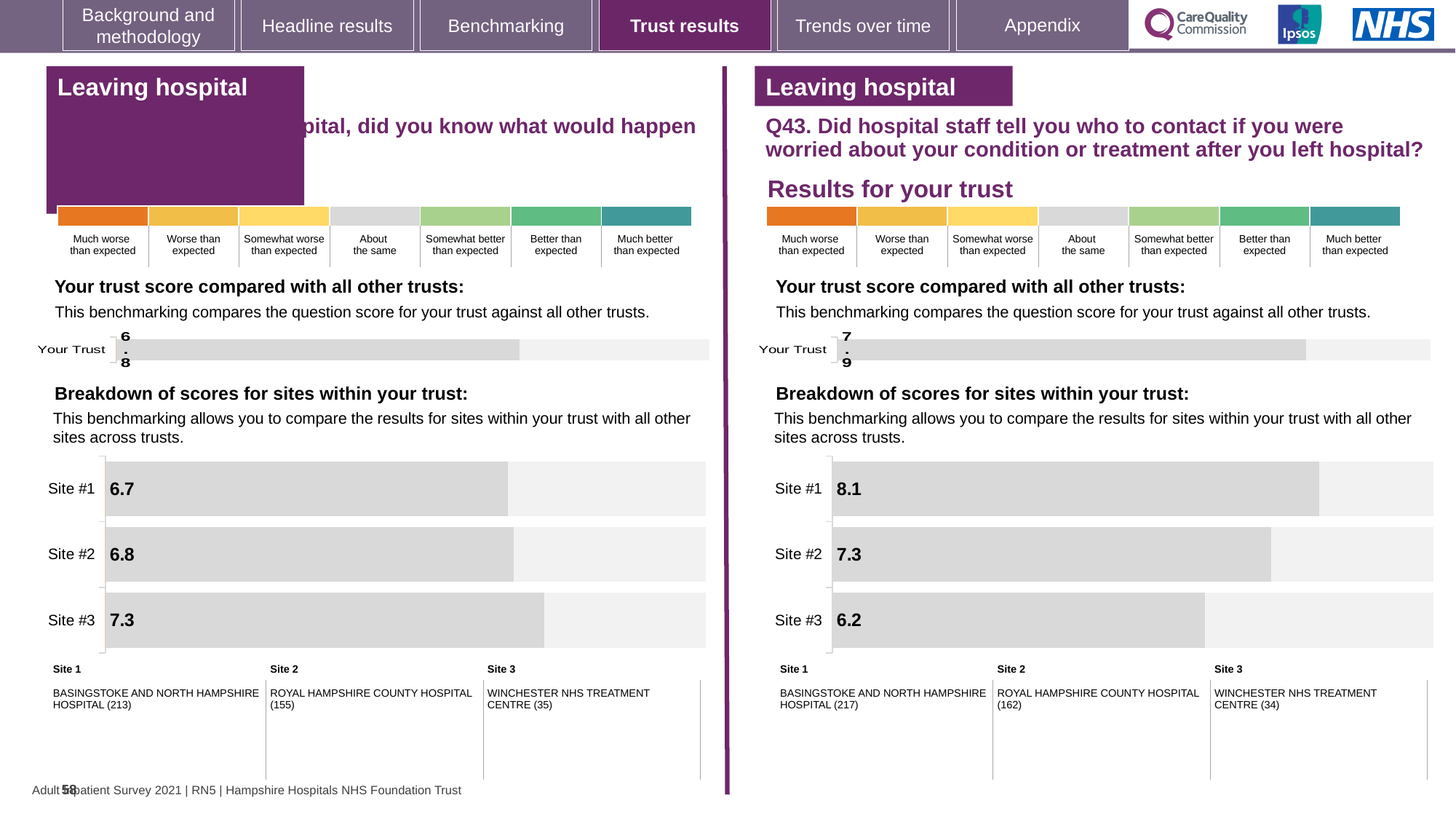
What type of chart is used for the site breakdown on the right-hand (Q43) side of the slide? Bar chart On the right-hand (Q43) 'Your trust score compared with all other trusts' chart, what is the score for Your Trust? 7.9 On the right-hand (Q43) site breakdown chart, what is the score for Site #1? 8.1 How many sites are shown on the left-hand site breakdown chart? 3 On the right-hand (Q43) site breakdown chart, do the scores rise or fall from Site #1 to Site #3? Fall On the right-hand (Q43) site breakdown chart, what is the difference between the scores for Site #1 and Site #3? 1.9 On the right-hand (Q43) site breakdown chart, which site has the lowest score? Site #3 On the left-hand site breakdown chart, what is the score for Site #3? 7.3 On the left-hand site breakdown chart, which site has the highest score? Site #3 On the left-hand site breakdown chart, what is the difference between the scores for Site #3 and Site #1? 0.6 On the left-hand 'Your trust score compared with all other trusts' chart, what is the score for Your Trust? 6.8 On the right-hand (Q43) site breakdown chart, which has the larger score, Site #2 or Site #3? Site #2